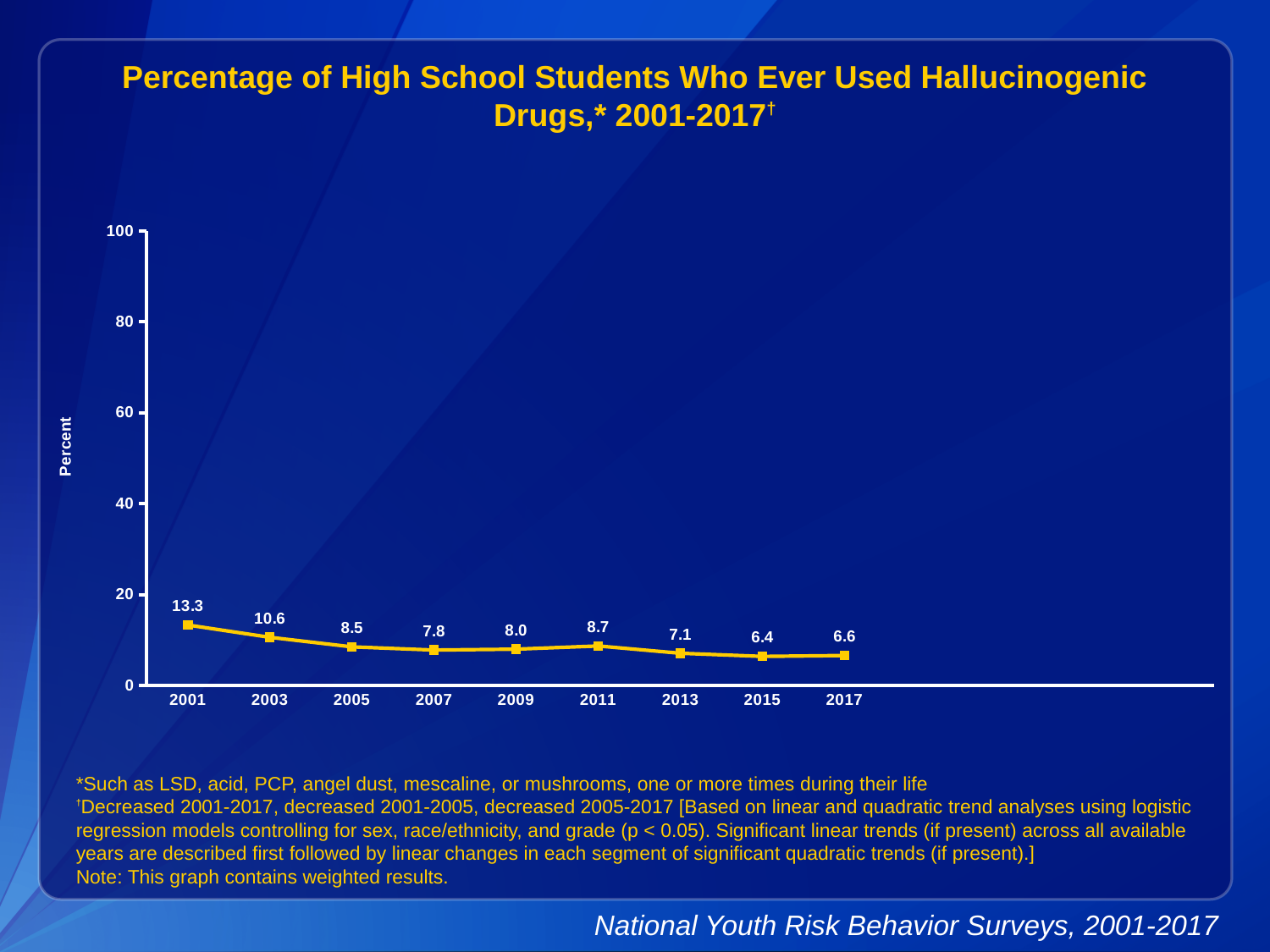
What was the percentage of high school students who ever used hallucinogenic drugs in 2001? 13.3 How many years are plotted on the x axis? 9 What kind of chart is shown on the slide? line chart What is the difference between the 2003 value and the 2005 value? 2.1 Which year has the lowest percentage? 2015 Which year has the highest percentage? 2001 What value is shown for 2011? 8.7 What is the difference between the 2001 value and the 2017 value? 6.7 Overall, do the values rise or fall from 2001 to 2017? fall What value is shown for 2017? 6.6 Which year has a higher value, 2009 or 2013? 2009 Is the value for 2001 greater or less than 20? less